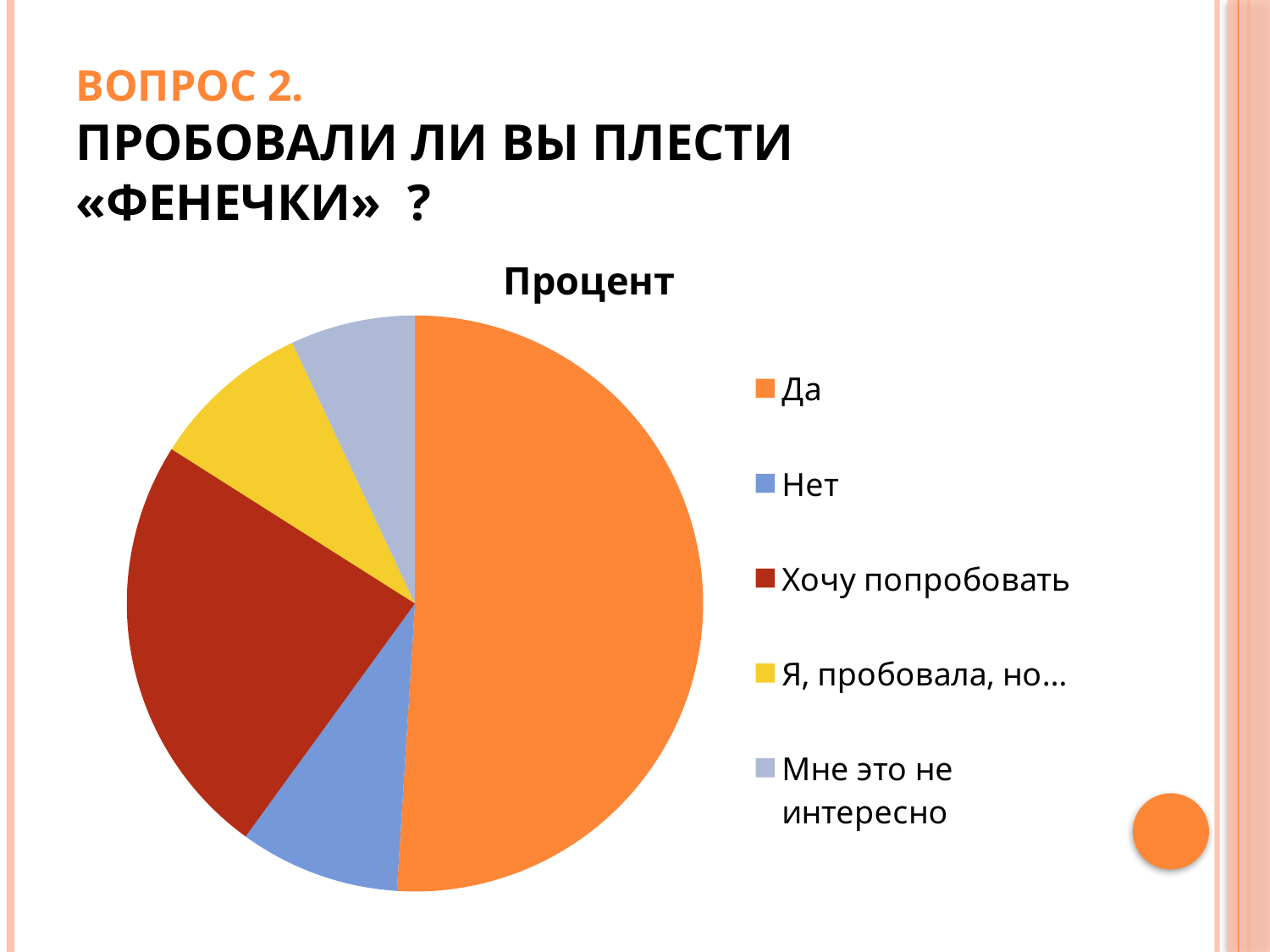
Which slice is larger, "Да" or "Мне это не интересно"? Да Which slice is larger, "Хочу попробовать" or "Нет"? Хочу попробовать What colour is the "Да" slice in the pie chart? orange What is the title of the pie chart? Процент How many slices does the pie chart have? 5 What kind of chart is shown on the slide? pie chart Which category has the largest slice in the pie chart? Да Which category has the second-largest slice in the pie chart? Хочу попробовать Which slice is larger, "Да" or "Хочу попробовать"? Да